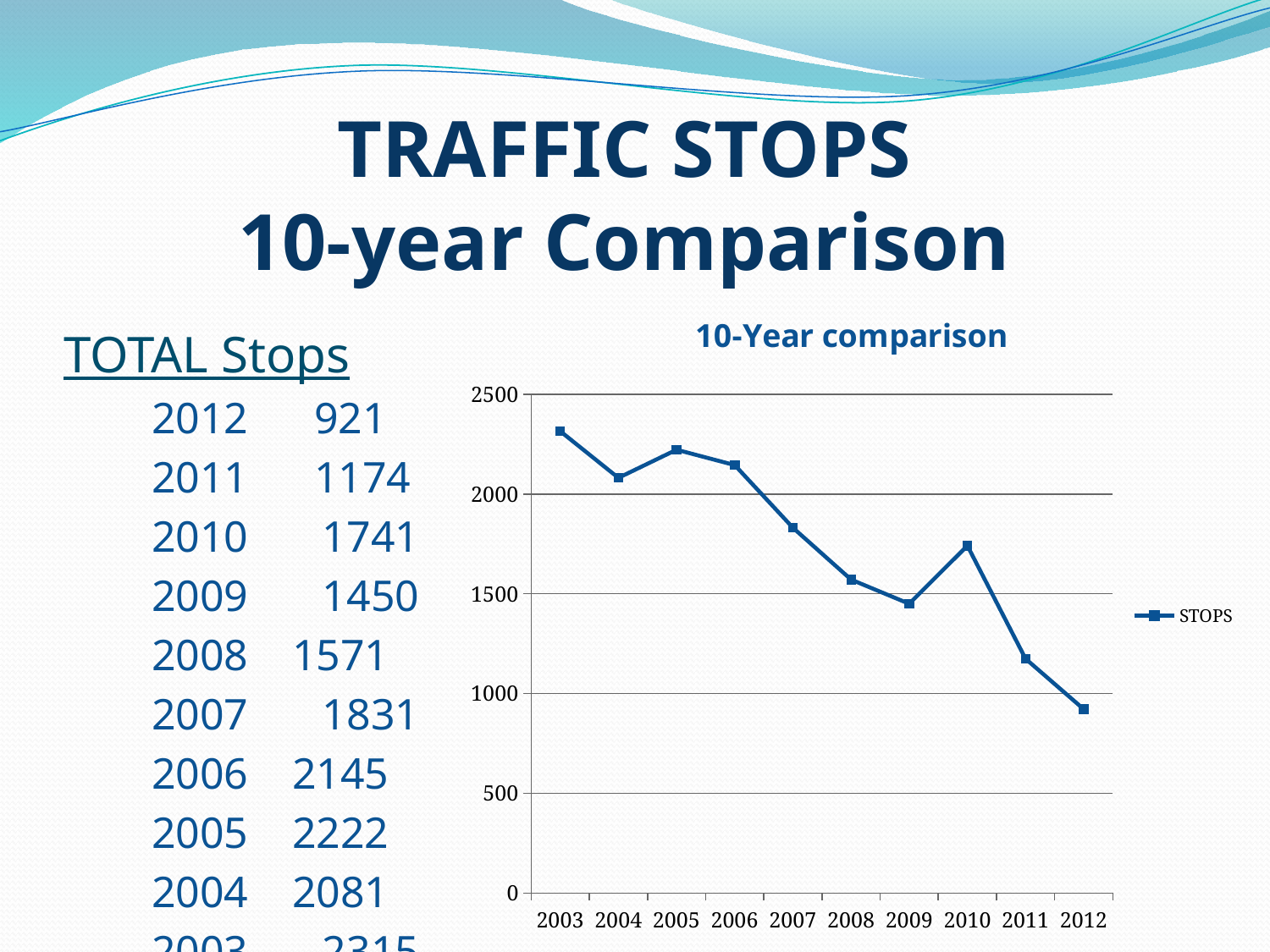
What is the title of the chart? 10-Year comparison Which year has more stops, 2008 or 2007? 2007 Which year has the highest number of stops? 2003 Which year has the lowest number of stops? 2012 What is the number of stops for 2012? 921 What is the difference in stops between 2009 and 2010? 291 How many years are plotted along the x axis of the chart? 10 Is the value for 2003 greater or less than 2000? greater What is the number of stops for 2005? 2222 How many series does the chart legend list? 1 What kind of chart is shown on the slide? line chart What is the number of stops for 2010? 1741